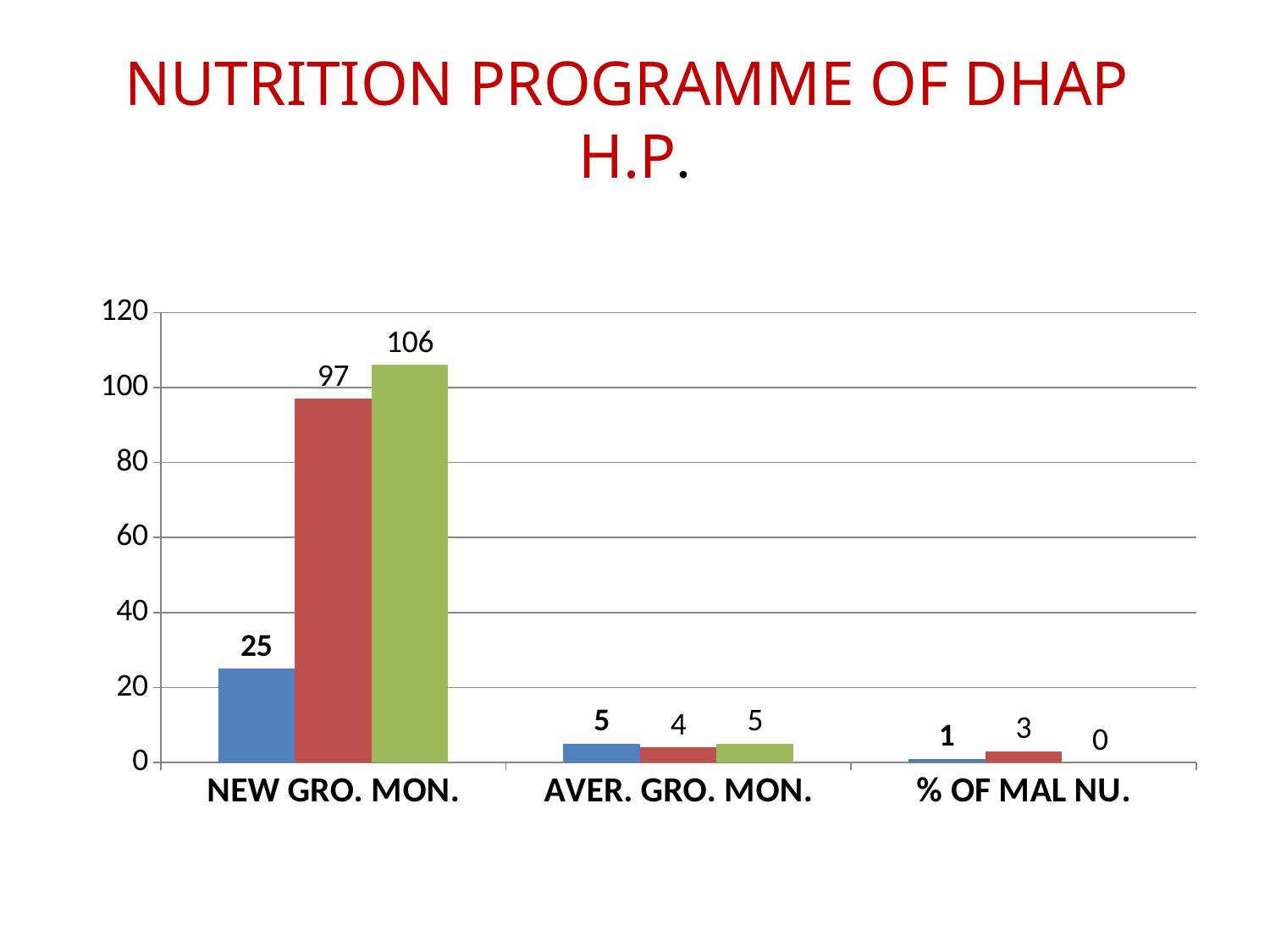
What is the value of the green bar for % OF MAL NU.? 0 Which category has the highest bar on the chart? NEW GRO. MON. How many categories are shown on the x axis? 3 What is the difference between the green bar and the red bar for NEW GRO. MON.? 9 What is the value of the red bar for % OF MAL NU.? 3 Is the value of the red bar for NEW GRO. MON. greater or less than 80? greater What is the value of the blue bar for NEW GRO. MON.? 25 What kind of chart is shown on the slide? bar chart What is the value of the red bar for AVER. GRO. MON.? 4 Which is larger for NEW GRO. MON., the red bar or the blue bar? the red bar What is the value of the green bar for NEW GRO. MON.? 106 What is the difference between the green bar and the blue bar for NEW GRO. MON.? 81